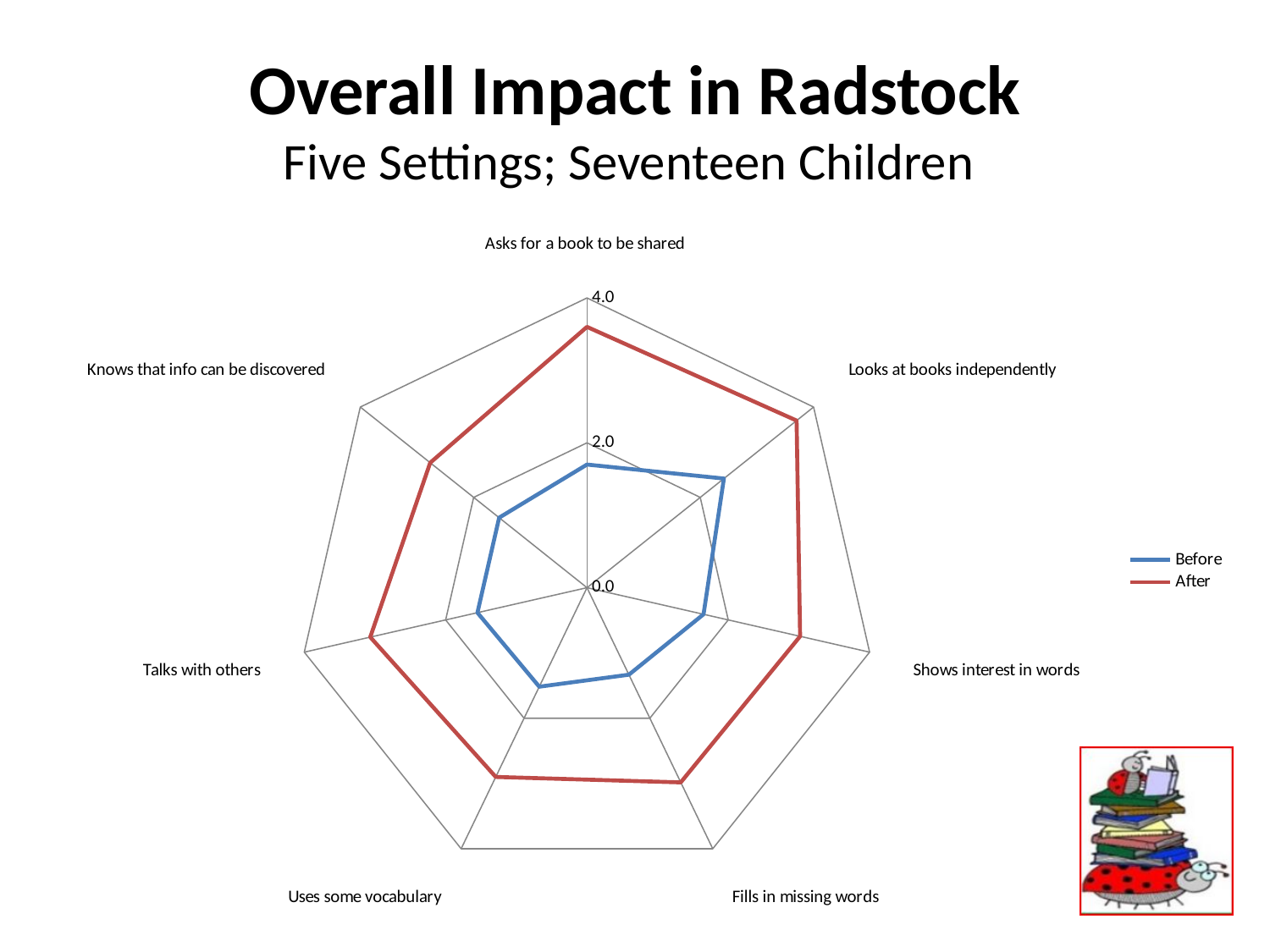
Is the Before value for 'Asks for a book to be shared' greater or less than 2.0? less How many series does the legend list? 2 Is the Before value for 'Fills in missing words' greater or less than 2.0? less What kind of chart is shown on the slide? Radar chart Which two series are shown in the legend? Before and After For 'Talks with others', which series has the larger value, Before or After? After Is the After value for 'Asks for a book to be shared' greater or less than 2.0? greater How many categories (axes) does the radar chart have? 7 Which category has the highest value for the Before series? Looks at books independently What colour is the line for the After series? Red